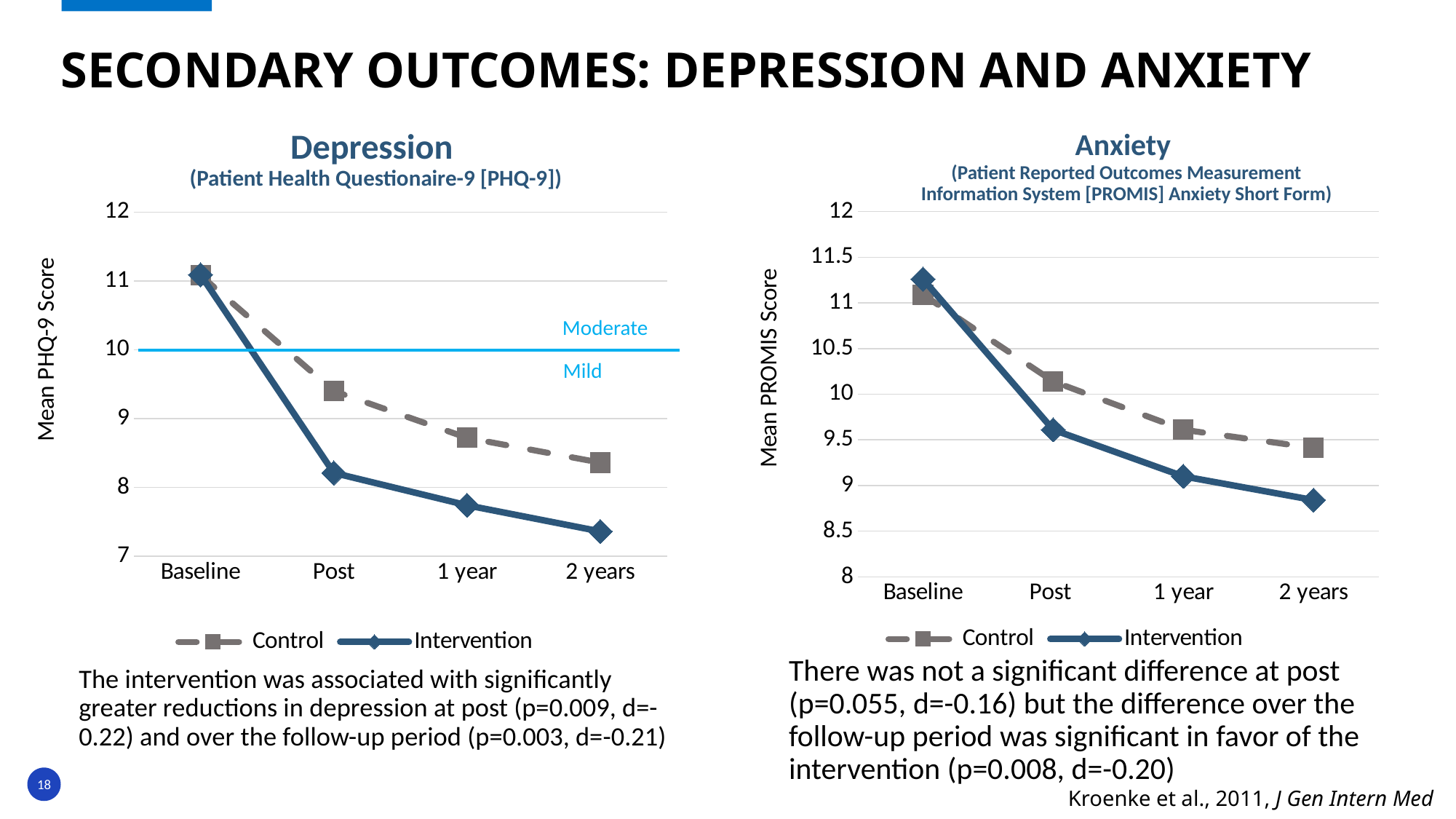
In the Depression chart, which series has the higher value at 2 years, Control or Intervention? Control In the Depression chart, is the Control value at Post greater or less than 9? greater In the Anxiety chart, is the Control value at 2 years greater or less than 10? less What kind of chart is the Depression chart? line chart In the Depression chart, what is the y-axis label? Mean PHQ-9 Score In the Depression chart, is the Intervention value at 2 years greater or less than 8? less In the Depression chart, does the Intervention line rise or fall from Baseline to 2 years? fall How many time points are plotted along the x axis of the Depression chart? 4 How many series does the legend of the Anxiety chart list? 2 In the Anxiety chart, does the Control line rise or fall from Baseline to 2 years? fall In the Anxiety chart, which series has the lower value at 1 year, Control or Intervention? Intervention